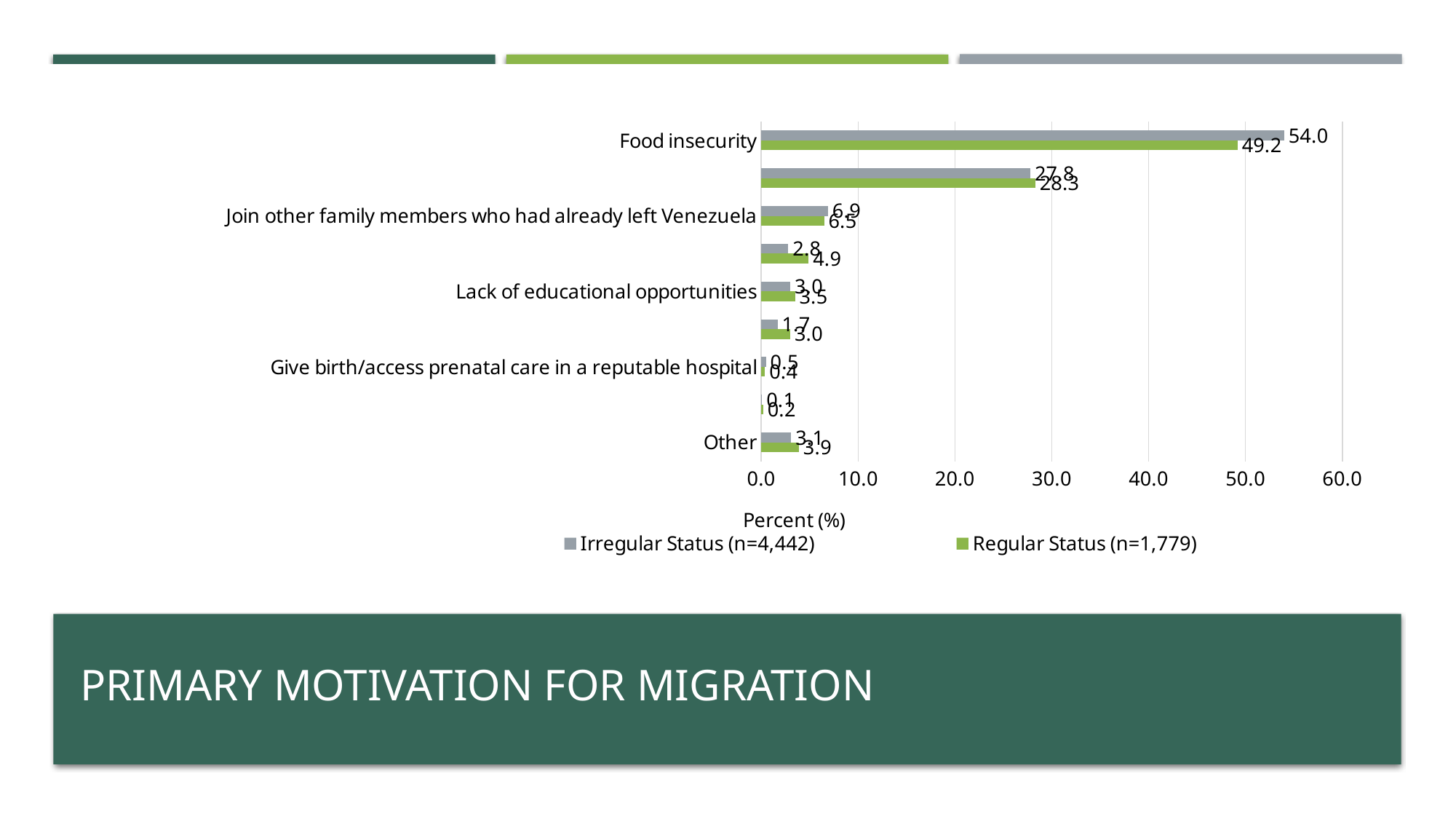
What is the Regular Status value for Other? 3.9 Which category has the highest Irregular Status value? Food insecurity What is the Irregular Status value for Food insecurity? 54.0 What is the Irregular Status value for 'Join other family members who had already left Venezuela'? 6.9 How many series does the legend list? 2 Is the Regular Status value for Food insecurity greater or less than 40.0? greater What is the title of the horizontal axis? Percent (%) What is the Regular Status value for Food insecurity? 49.2 What is the difference between the Irregular Status and Regular Status values for Food insecurity? 4.8 For 'Lack of educational opportunities', which series has the larger value, Irregular Status or Regular Status? Regular Status What kind of chart is shown on the slide? Bar chart What is the Regular Status value for 'Give birth/access prenatal care in a reputable hospital'? 0.4